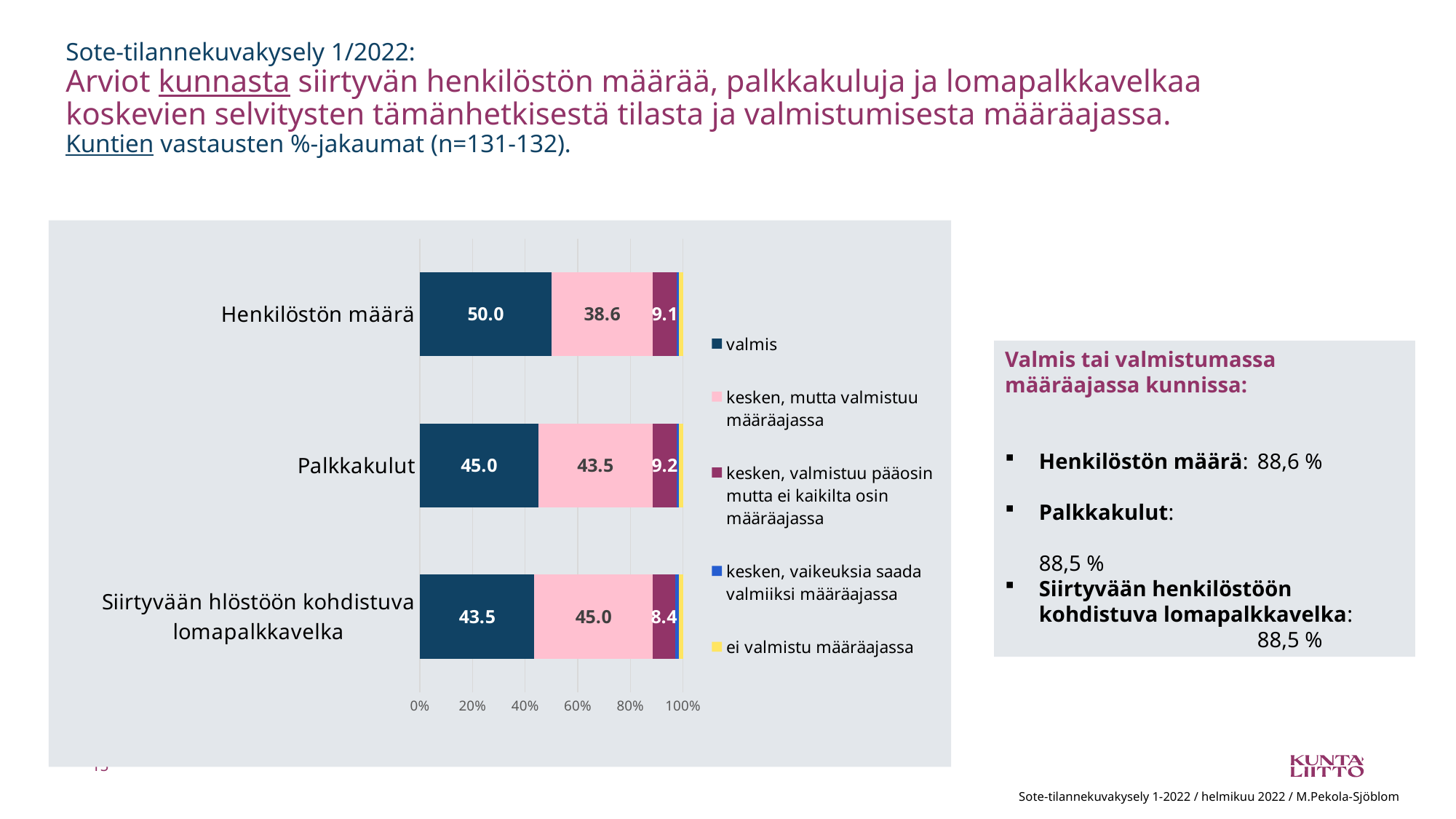
Which category has the lowest "kesken, mutta valmistuu määräajassa" value? Henkilöstön määrä What is the difference between the "valmis" values for Henkilöstön määrä and Palkkakulut? 5.0 Which legend entry is shown in yellow? ei valmistu määräajassa Is the "valmis" value for Siirtyvään hlöstöön kohdistuva lomapalkkavelka greater or less than 40%? greater What is the value of the "kesken, mutta valmistuu määräajassa" segment for Palkkakulut? 43.5 What kind of chart is shown on the slide? Stacked bar chart Which is larger: the "valmis" value for Palkkakulut or the "valmis" value for Siirtyvään hlöstöön kohdistuva lomapalkkavelka? Palkkakulut What is the value of the "valmis" segment for Henkilöstön määrä? 50.0 How many series does the legend list? 5 How many categories are shown on the chart? 3 What is the value of the "kesken, valmistuu pääosin mutta ei kaikilta osin määräajassa" segment for Siirtyvään hlöstöön kohdistuva lomapalkkavelka? 8.4 Which category has the highest "valmis" value? Henkilöstön määrä